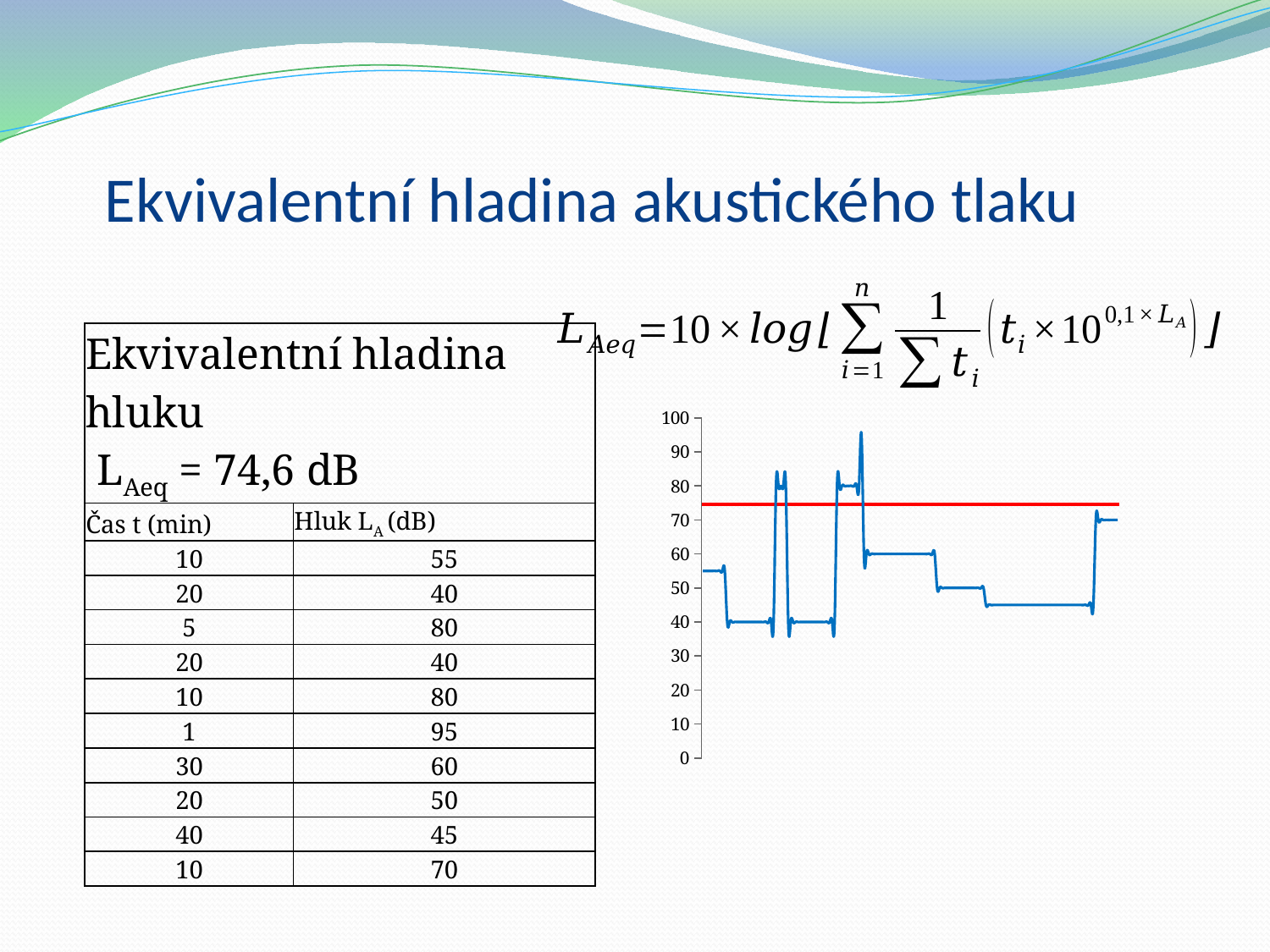
What kind of chart is shown on the right of the slide? line chart What is the maximum value shown on the chart's vertical axis? 100 Is the highest peak of the blue line above or below the red horizontal line? above Is the red horizontal line greater or less than 80? less Is the lowest level of the blue line greater or less than 50? less Is the level of the blue line at the far right of the chart greater or less than 60? greater What colour is the horizontal reference line on the chart? red